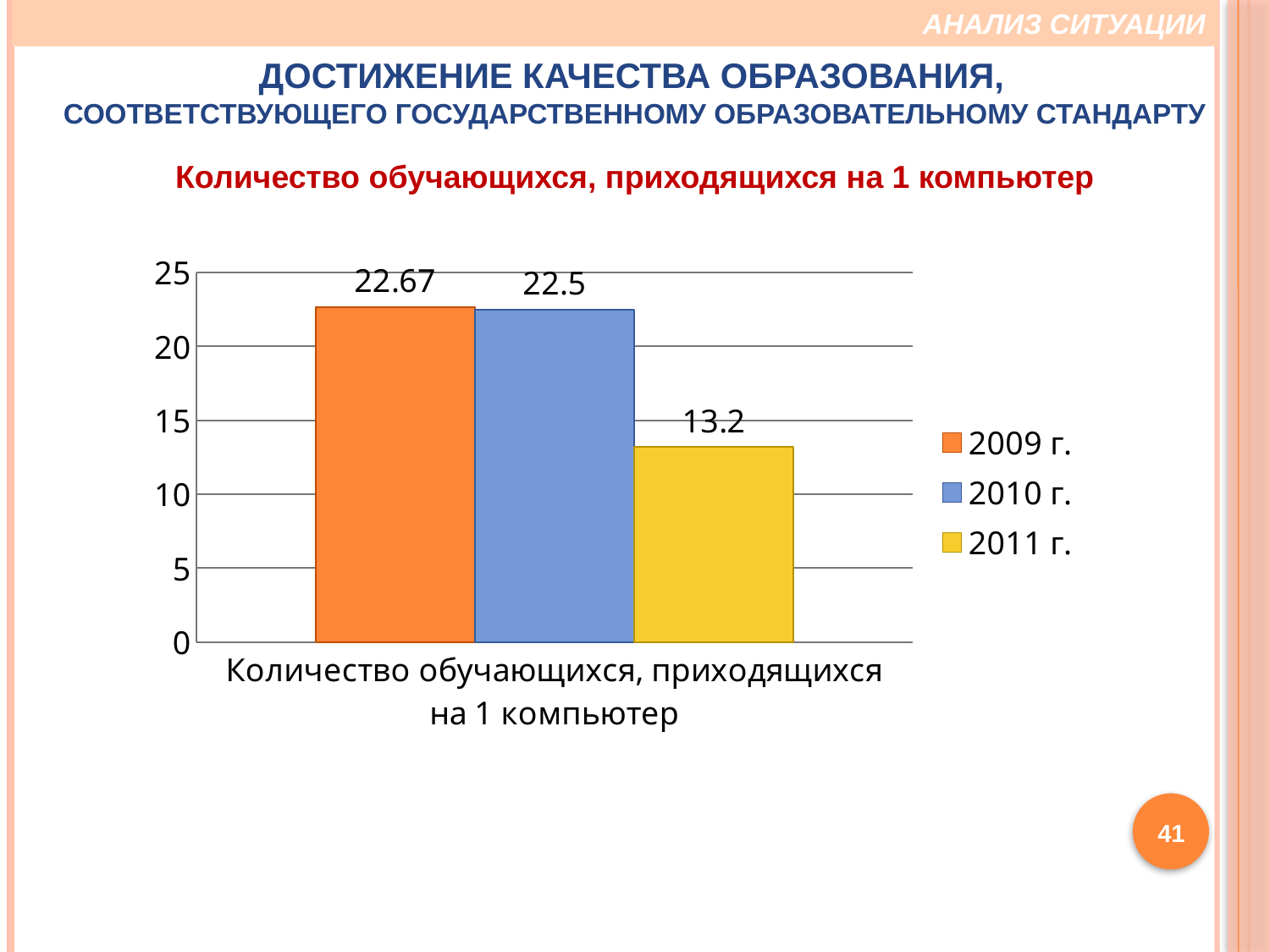
What is the difference between the values for 2009 г. and 2010 г.? 0.17 Which year has the lowest number of students per computer? 2011 г. What is the value for 2011 г.? 13.2 Is the value for 2011 г. greater or less than 15? less What kind of chart is shown on the slide? bar chart What is the difference between the values for 2010 г. and 2011 г.? 9.3 Is the value for 2009 г. greater or less than 20? greater Which is larger, the value for 2010 г. or the value for 2011 г.? 2010 г. What is the value for 2010 г.? 22.5 What colour is the bar for 2011 г.? yellow What is the value for 2009 г.? 22.67 How many series does the legend list? 3